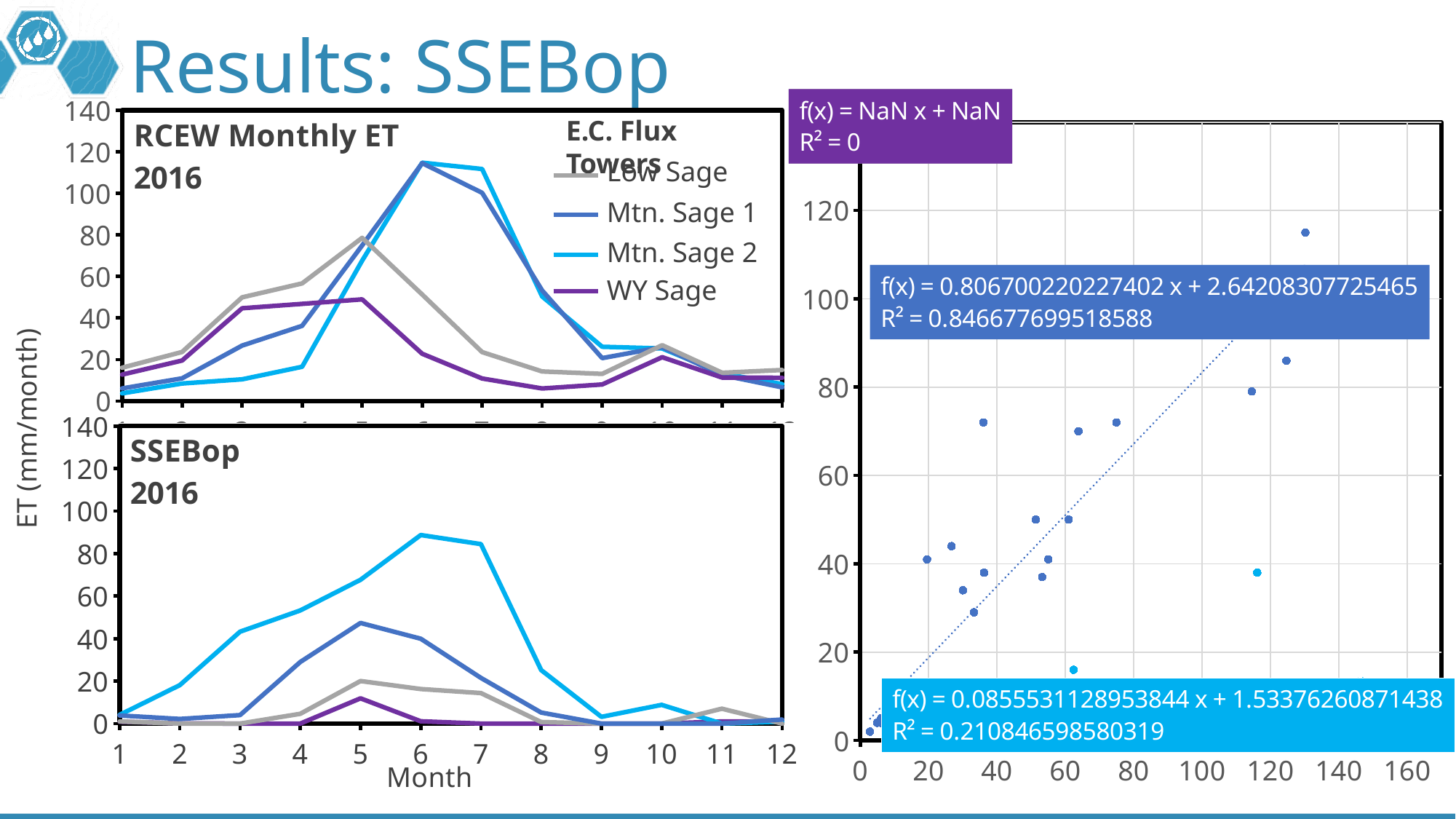
How many months are shown along the x axis of the 'SSEBop 2016' chart? 12 In the 'SSEBop 2016' chart, which series reaches the highest peak value? Mtn. Sage 2 In the 'RCEW Monthly ET 2016' chart, which series has the lowest peak value? WY Sage In the scatter chart on the right, what R² value is shown in the dark blue trendline label? 0.846677699518588 In the 'RCEW Monthly ET 2016' chart, is the Low Sage value at month 5 greater or less than 60? greater In the 'SSEBop 2016' chart, does the Mtn. Sage 2 line rise or fall from month 7 to month 9? fall What kind of chart is the 'RCEW Monthly ET 2016' chart on the top left? line chart What is the y-axis label shared by the two charts on the left? ET (mm/month) In the 'SSEBop 2016' chart at month 5, which is larger, Mtn. Sage 1 or Low Sage? Mtn. Sage 1 In the 'SSEBop 2016' chart, is the Mtn. Sage 2 value at month 6 greater or less than 80? greater In the 'SSEBop 2016' chart, is the WY Sage value at month 5 greater or less than 20? less How many series does the legend of the 'RCEW Monthly ET 2016' chart list? 4